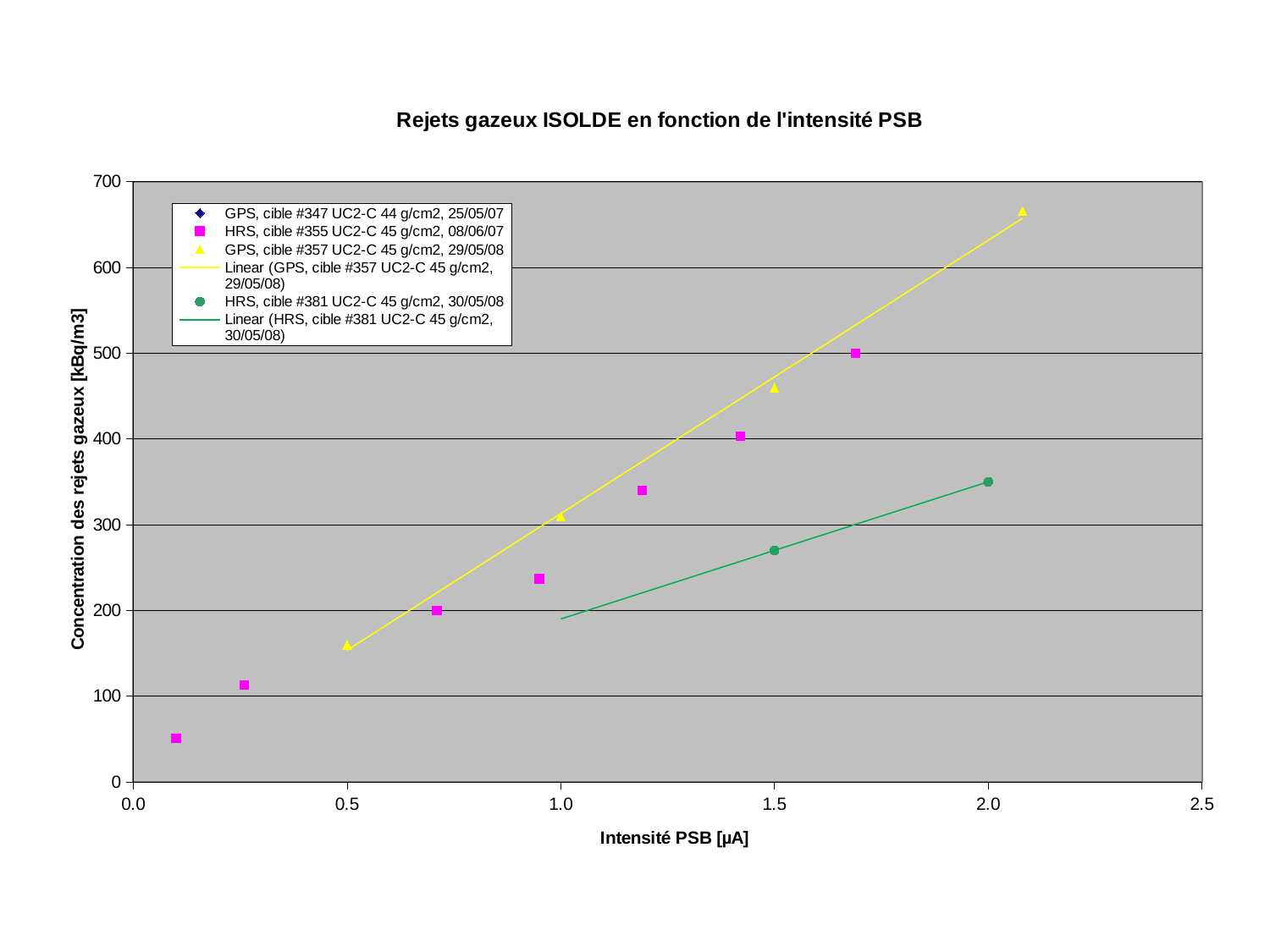
Do the concentration values rise or fall as the PSB intensity increases? rise At 1.5 µA, which series has the higher concentration: 'GPS, cible #357' or 'HRS, cible #381'? GPS, cible #357 UC2-C 45 g/cm2, 29/05/08 What is the title of the chart? Rejets gazeux ISOLDE en fonction de l'intensité PSB How many data points are plotted for the series 'HRS, cible #381 UC2-C 45 g/cm2, 30/05/08' (green circles)? 2 Is the concentration for the 'HRS, cible #381' series at 2.0 µA greater or less than 400 kBq/m3? less How many entries does the legend list? 6 Is the concentration for the 'GPS, cible #357' series at its highest intensity (about 2.1 µA) greater or less than 600 kBq/m3? greater How many data points are plotted for the series 'HRS, cible #355 UC2-C 45 g/cm2, 08/06/07' (magenta squares)? 7 Is the concentration for the 'GPS, cible #357' series at 0.5 µA greater or less than 200 kBq/m3? less How many data points are plotted for the series 'GPS, cible #357 UC2-C 45 g/cm2, 29/05/08' (yellow triangles)? 4 What is the label of the x axis? Intensité PSB [µA] What kind of chart is shown on the slide? scatter chart